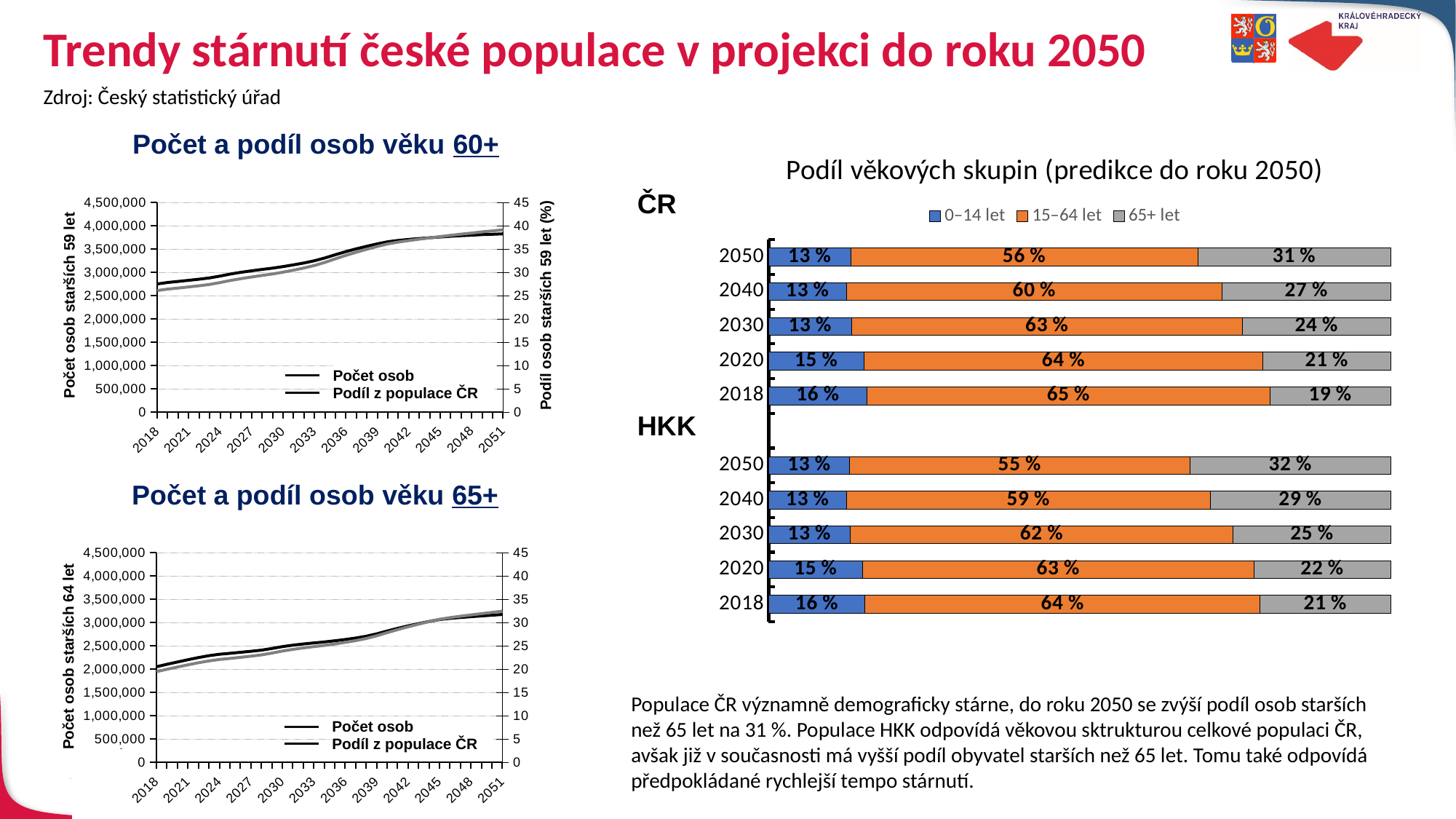
In the chart 'Podíl věkových skupin (predikce do roku 2050)', which is larger: the 65+ let share for HKK in 2030 or for ČR in 2030? HKK in 2030 What kind of chart is 'Podíl věkových skupin (predikce do roku 2050)'? Stacked bar chart In the chart 'Podíl věkových skupin (predikce do roku 2050)', what is the share of the 65+ let group for ČR in 2050? 31 % In the chart 'Počet a podíl osob věku 60+', is the Počet osob value in 2018 greater or less than 2,500,000? greater How many series does the legend of the chart 'Podíl věkových skupin (predikce do roku 2050)' list? 3 In the chart 'Podíl věkových skupin (predikce do roku 2050)', what is the share of the 15–64 let group for HKK in 2018? 64 % In the chart 'Počet a podíl osob věku 65+', is the Počet osob value in 2051 greater or less than 3,000,000? greater In the chart 'Počet a podíl osob věku 60+', does the Počet osob series rise or fall from 2018 to 2051? Rise In the chart 'Podíl věkových skupin (predikce do roku 2050)', which year has the lowest share of the 15–64 let group for ČR? 2050 In the chart 'Podíl věkových skupin (predikce do roku 2050)', what is the share of the 0–14 let group for ČR in 2020? 15 % In the chart 'Podíl věkových skupin (predikce do roku 2050)', what is the difference between the 65+ let share for ČR in 2050 and in 2018? 12 % In the chart 'Podíl věkových skupin (predikce do roku 2050)', which year has the highest share of the 65+ let group for HKK? 2050